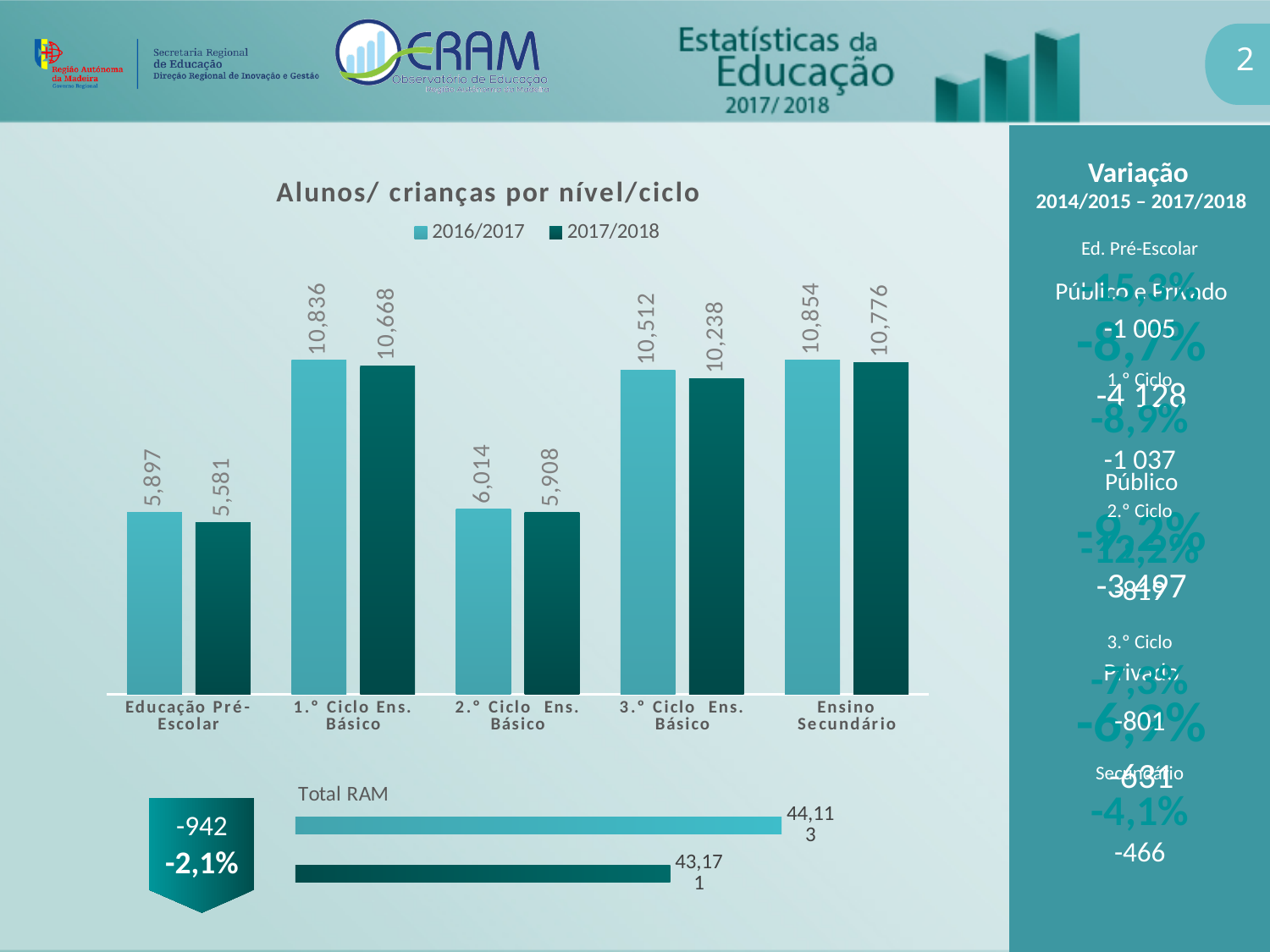
On the 'Total RAM' chart at the bottom of the slide, what is the value of the top (lighter) bar? 44,113 On the chart 'Alunos/ crianças por nível/ciclo', what is the value for 1.º Ciclo Ens. Básico in 2016/2017? 10,836 On the chart 'Alunos/ crianças por nível/ciclo', which is larger: the 2017/2018 value for 2.º Ciclo Ens. Básico or the 2017/2018 value for Educação Pré-Escolar? 2.º Ciclo Ens. Básico How many categories are shown on the chart 'Alunos/ crianças por nível/ciclo'? 5 On the chart 'Alunos/ crianças por nível/ciclo', which category has the highest value in 2017/2018? Ensino Secundário On the chart 'Alunos/ crianças por nível/ciclo', what is the value for 3.º Ciclo Ens. Básico in 2017/2018? 10,238 What kind of chart is 'Alunos/ crianças por nível/ciclo'? Bar chart On the chart 'Alunos/ crianças por nível/ciclo', which category has the lowest value in 2016/2017? Educação Pré-Escolar On the chart 'Alunos/ crianças por nível/ciclo', what is the difference between the 2016/2017 and 2017/2018 values for 3.º Ciclo Ens. Básico? 274 How many series does the legend of the chart 'Alunos/ crianças por nível/ciclo' list? 2 On the chart 'Alunos/ crianças por nível/ciclo', what is the value for Educação Pré-Escolar in 2017/2018? 5,581 On the chart 'Alunos/ crianças por nível/ciclo', what is the difference between the 2016/2017 and 2017/2018 values for Educação Pré-Escolar? 316